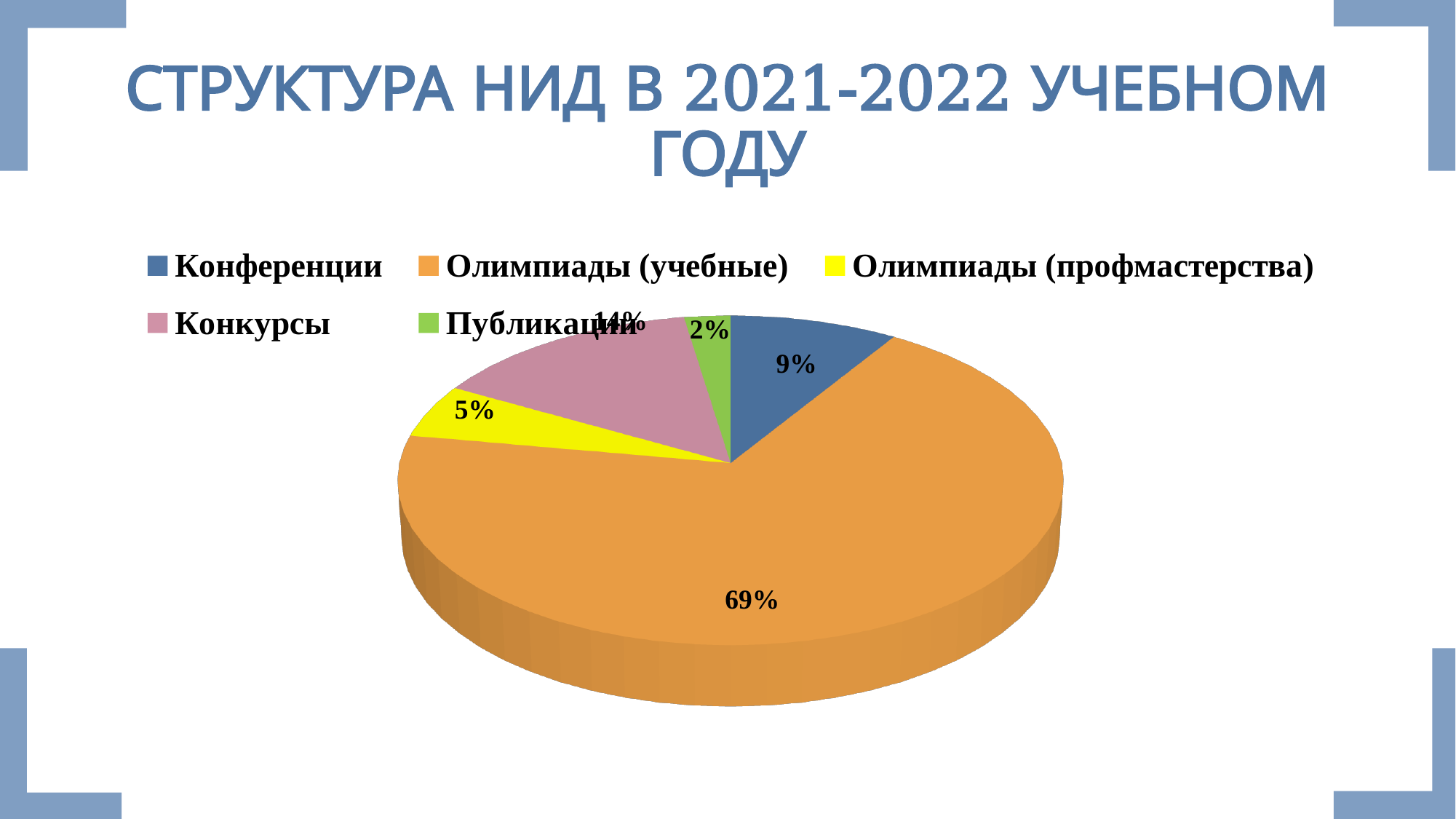
Which is larger, the share for Конференции or the share for Олимпиады (профмастерства)? Конференции What is the difference between the shares of Олимпиады (учебные) and Конференции? 60% What share of the pie does Олимпиады (профмастерства) have? 5% What colour is the slice for Олимпиады (профмастерства)? yellow What share of the pie does Конференции have? 9% What share of the pie does Олимпиады (учебные) have? 69% What kind of chart is shown on the slide? pie chart How many categories does the legend list? 5 Which category has the smallest slice of the pie? Публикации What is the title of the slide? СТРУКТУРА НИД В 2021-2022 УЧЕБНОМ ГОДУ What share of the pie does Публикации have? 2% Which category has the largest slice of the pie? Олимпиады (учебные)